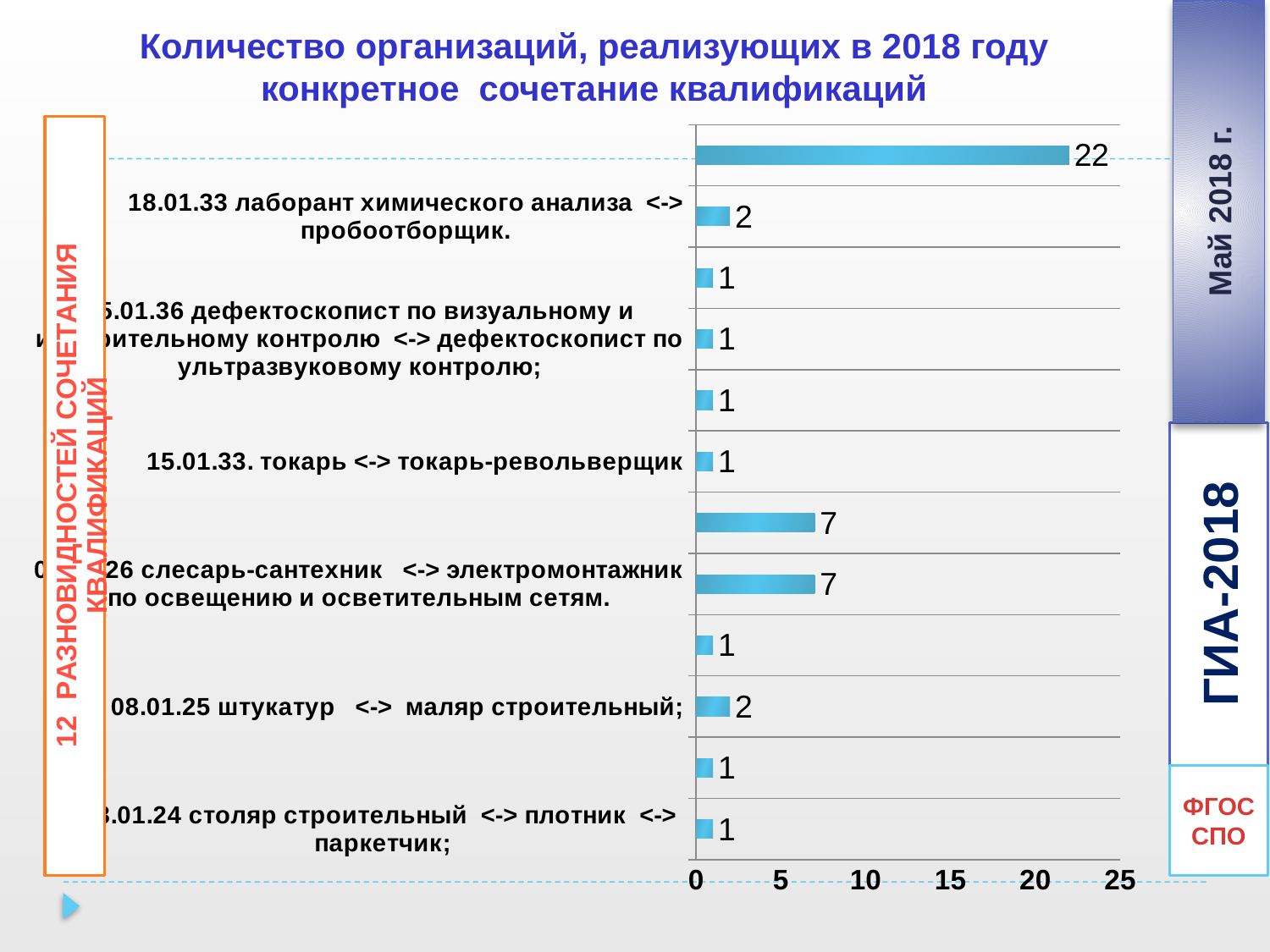
What is the value for '18.01.33 лаборант химического анализа <-> пробоотборщик'? 2 How many bars in the chart have a value of 7? 2 What is the title of the chart? Количество организаций, реализующих в 2018 году конкретное сочетание квалификаций Which has a larger value: '08.01.26 слесарь-сантехник <-> электромонтажник' or '08.01.25 штукатур <-> маляр строительный'? 08.01.26 слесарь-сантехник <-> электромонтажник What is the difference between the values for '08.01.26 слесарь-сантехник <-> электромонтажник' and '08.01.25 штукатур <-> маляр строительный'? 5 What is the value for '08.01.26 слесарь-сантехник <-> электромонтажник по освещению и осветительным сетям'? 7 What is the value for '15.01.33. токарь <-> токарь-револьверщик'? 1 How many bars are plotted in the chart? 12 What is the value for '08.01.24 столяр строительный <-> плотник <-> паркетчик'? 1 What is the highest value shown in the chart? 22 What kind of chart is shown on the slide? bar chart What is the value for '08.01.25 штукатур <-> маляр строительный'? 2